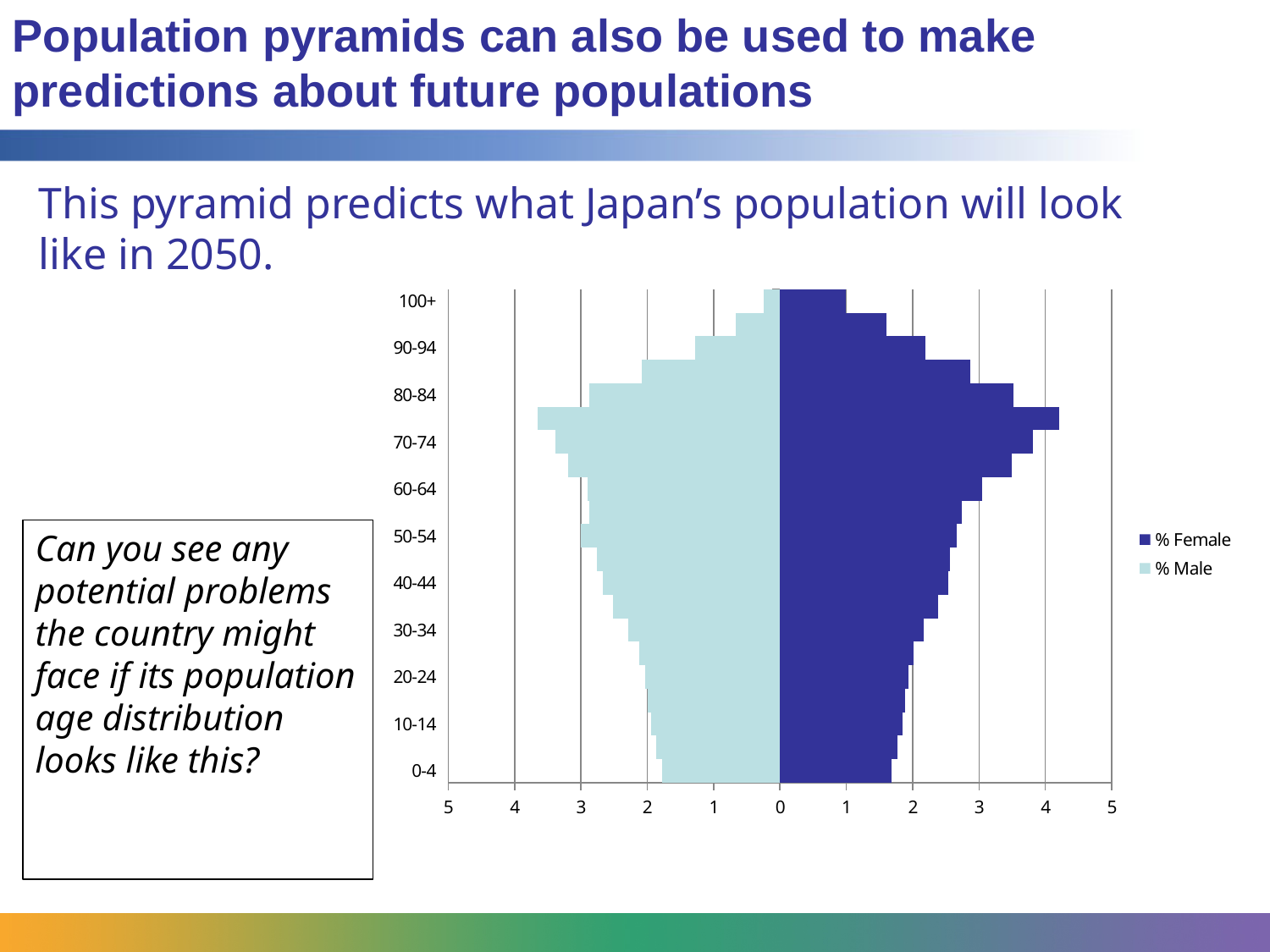
Moving up from the 0-4 age group to the 70-74 age group, do the % Female values rise or fall? rise Is the % Female value for the 70-74 age group greater or less than 3? greater What are the two series named in the legend? % Female and % Male What kind of chart is shown on the slide? bar chart How many series does the legend list? 2 Which is larger, the % Female value for the 70-74 age group or for the 0-4 age group? 70-74 Is the % Male value for the 0-4 age group greater or less than 2? less Is the % Male value for the 100+ age group greater or less than 1? less How many age-group labels are shown on the vertical axis? 11 Which series is drawn in dark blue? % Female